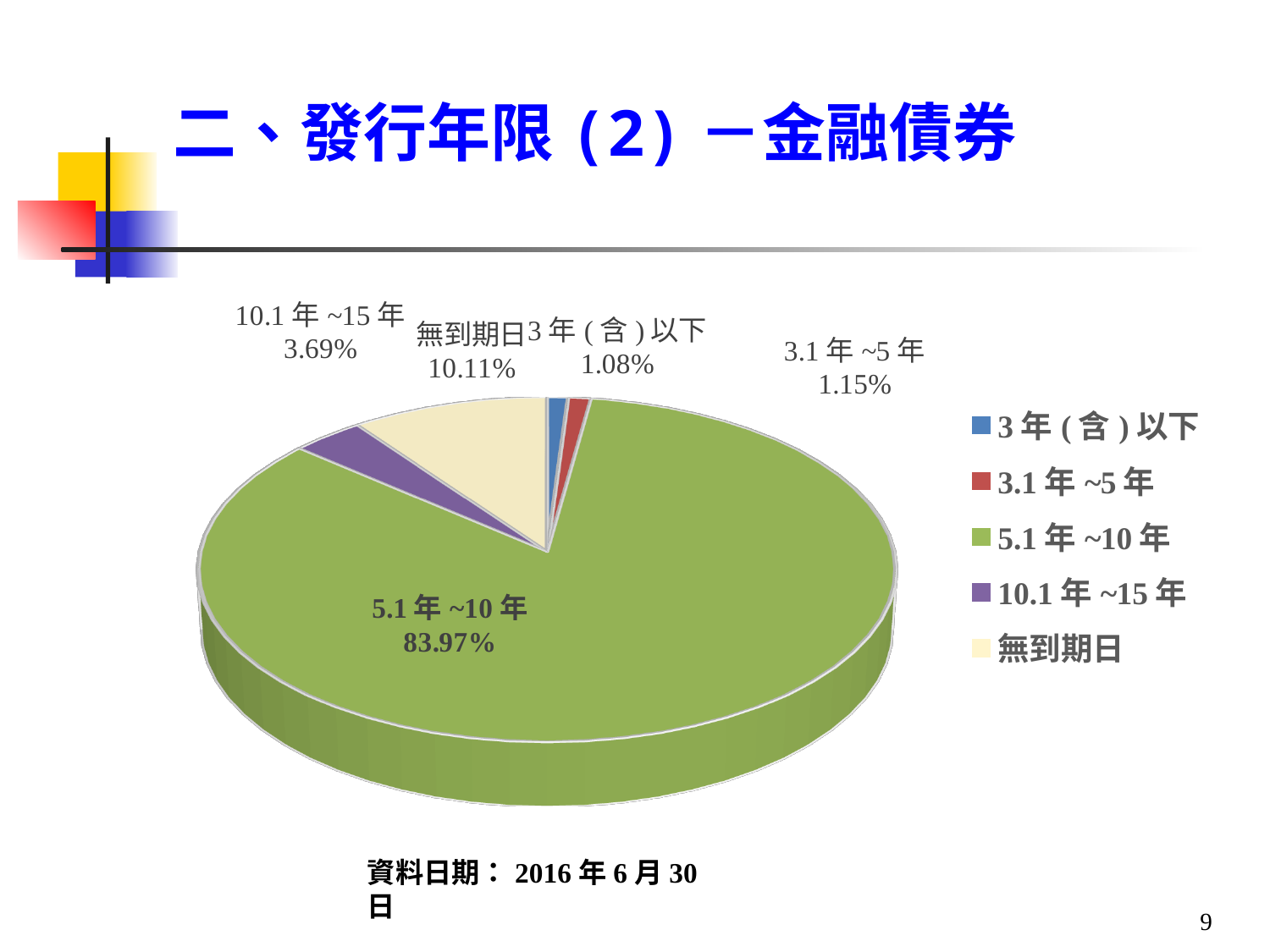
What is the value shown for 10.1年~15年? 3.69% What is the difference in percentage points between the 無到期日 slice and the 10.1年~15年 slice? 6.42 Which category has the largest slice of the pie? 5.1年~10年 What is the value shown for 3年(含)以下? 1.08% How many slices does the pie chart have? 5 What share of the pie does 5.1年~10年 account for? 83.97% Which category has the smallest slice of the pie? 3年(含)以下 How many entries does the legend list? 5 What kind of chart is shown on the slide? pie chart What is the value shown for 無到期日? 10.11% Which is larger, the slice for 無到期日 or the slice for 10.1年~15年? 無到期日 What is the value shown for 3.1年~5年? 1.15%